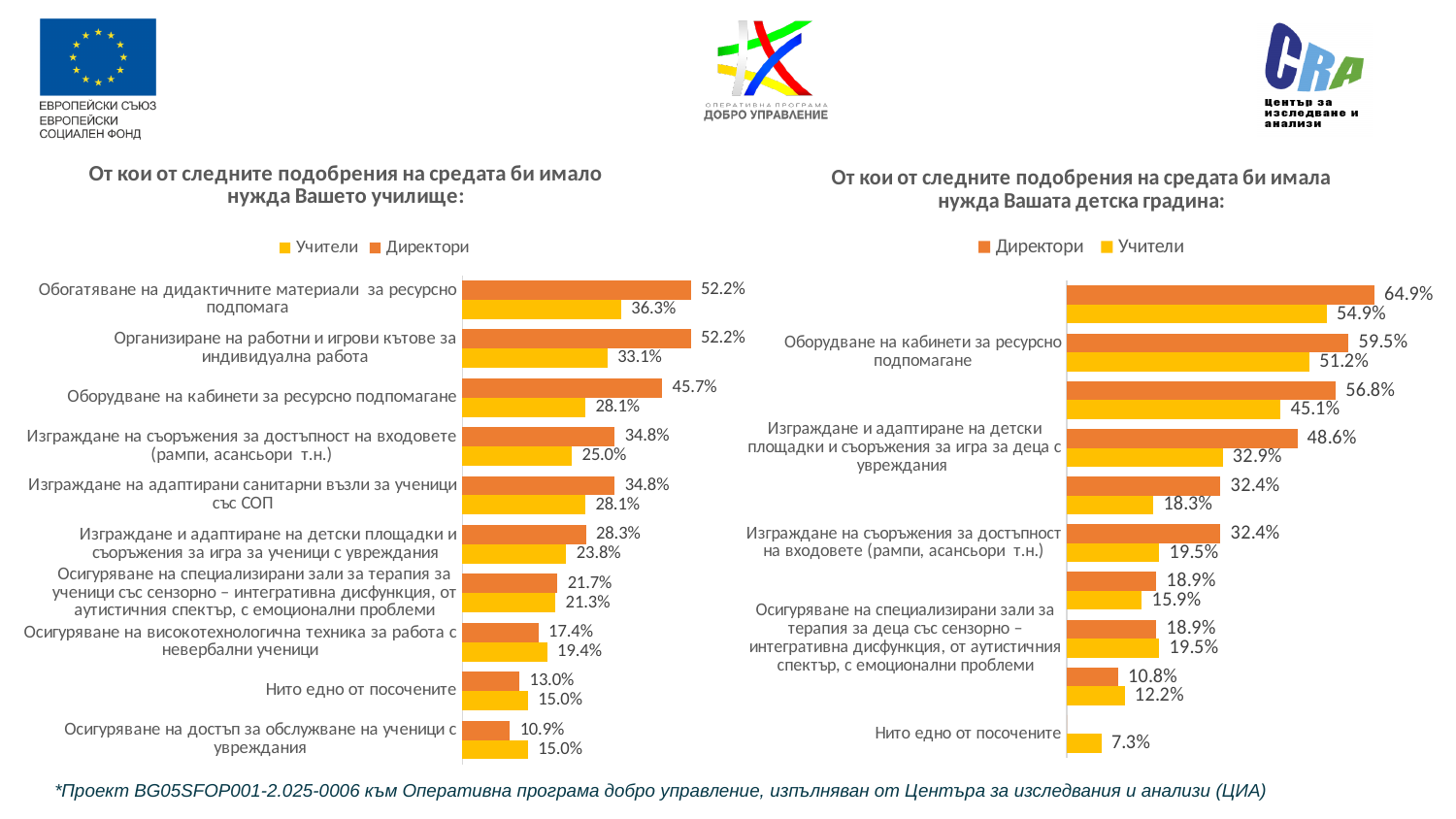
On the left chart (Вашето училище), which series has the larger value for 'Осигуряване на високотехнологична техника за работа с невербални ученици'? Учители On the right chart (Вашата детска градина), what is the highest value shown? 64.9% On the right chart (Вашата детска градина), what is the lowest value shown? 7.3% On the left chart (Вашето училище), what is the value for Директори for 'Оборудване на кабинети за ресурсно подпомагане'? 45.7% On the left chart (Вашето училище), what is the value for Учители for 'Обогатяване на дидактичните материали за ресурсно подпомага'? 36.3% On the right chart (Вашата детска градина), which series is listed first in the legend? Директори What kind of chart is the left chart (Вашето училище)? Bar chart How many series does the legend of the left chart (Вашето училище) list? 2 On the left chart (Вашето училище), which category has the lowest value for Директори? Осигуряване на достъп за обслужване на ученици с увреждания On the left chart (Вашето училище), what is the difference between Директори and Учители for 'Обогатяване на дидактичните материали за ресурсно подпомага'? 15.9 percentage points How many categories are shown on the left chart (Вашето училище)? 10 On the left chart (Вашето училище), what is the value for Учители for 'Нито едно от посочените'? 15.0%